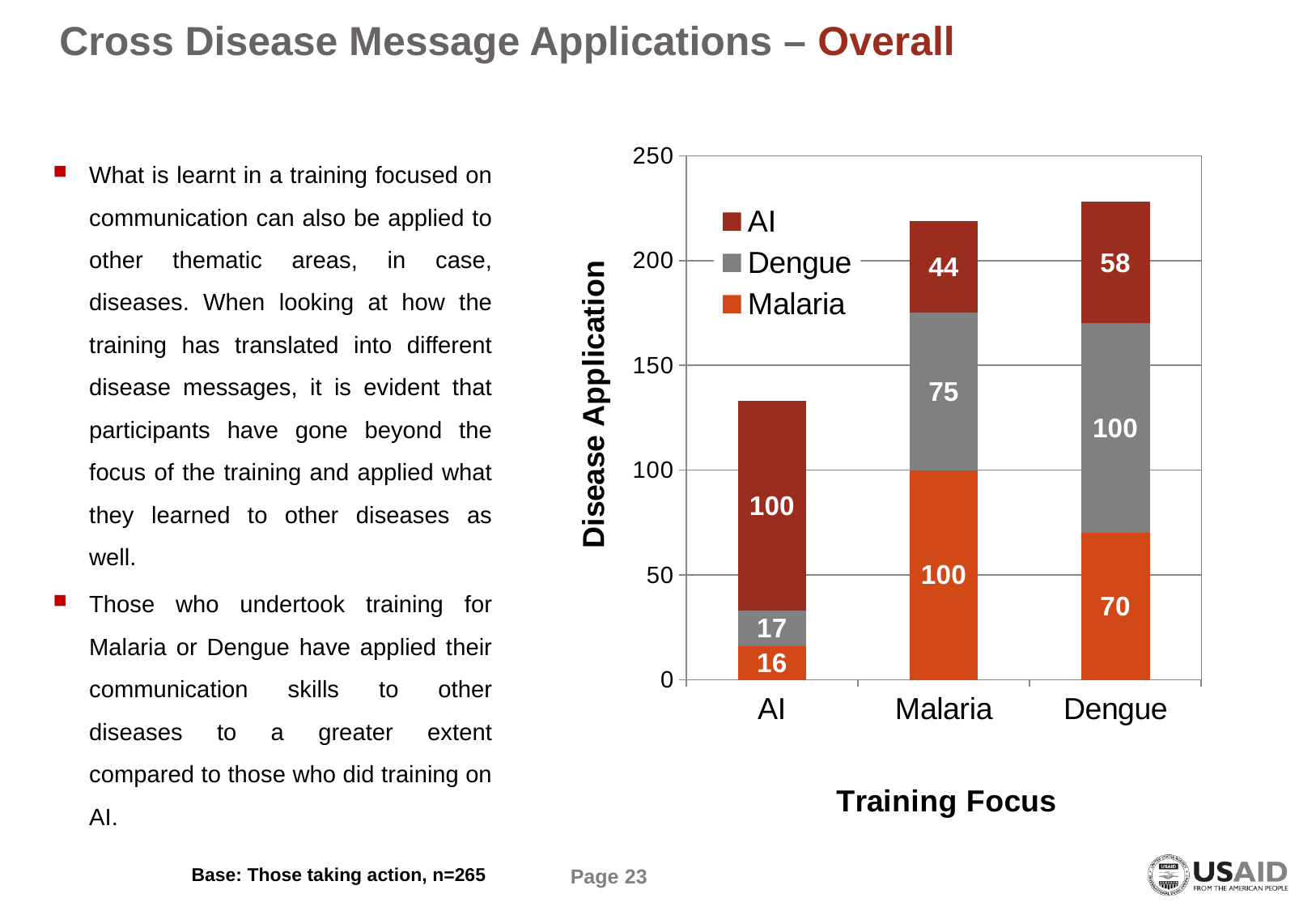
Which is larger: the Malaria value for the Dengue training focus or the Malaria value for the AI training focus? Dengue training focus What is the Dengue value for the Malaria training focus? 75 What is the total of the stacked bar for the AI training focus? 133 What kind of chart is shown on the slide? Stacked bar chart What is the Malaria value for the AI training focus? 16 How many training focus categories are shown on the x axis? 3 What is the label of the y axis? Disease Application How many series does the legend list? 3 What is the AI value for the Dengue training focus? 58 What is the total of the stacked bar for the Malaria training focus? 219 Which training focus has the tallest stacked bar overall? Dengue What is the difference between the AI values for the Dengue and Malaria training focus bars? 14